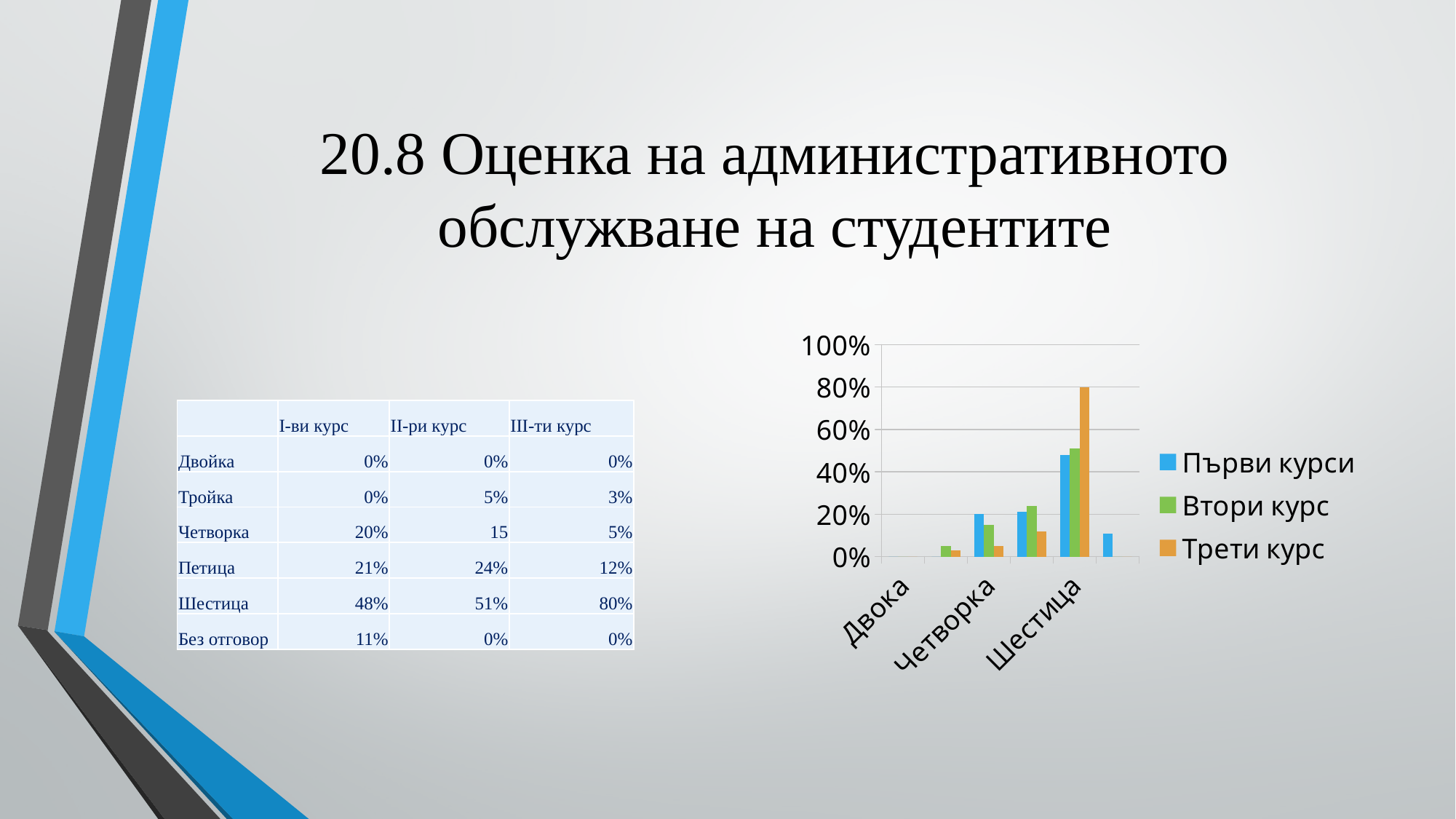
Is the value for Втори курс at Шестица greater or less than 40%? greater Is the value for Трети курс at Шестица greater or less than 60%? greater At Шестица, which series has the tallest bar? Трети курс What colour are the bars for the series Трети курс? orange What are the three series named in the chart legend? Първи курси, Втори курс, Трети курс How many series does the chart legend list? 3 Is the value for Първи курси at Шестица greater or less than 60%? less What kind of chart is shown on the slide? bar chart According to the table on the slide, what is the value for Петица in II-ри курс? 24% At Шестица, which is larger: the bar for Трети курс or the bar for Първи курси? Трети курс According to the table on the slide, what is the value for Шестица in III-ти курс? 80%